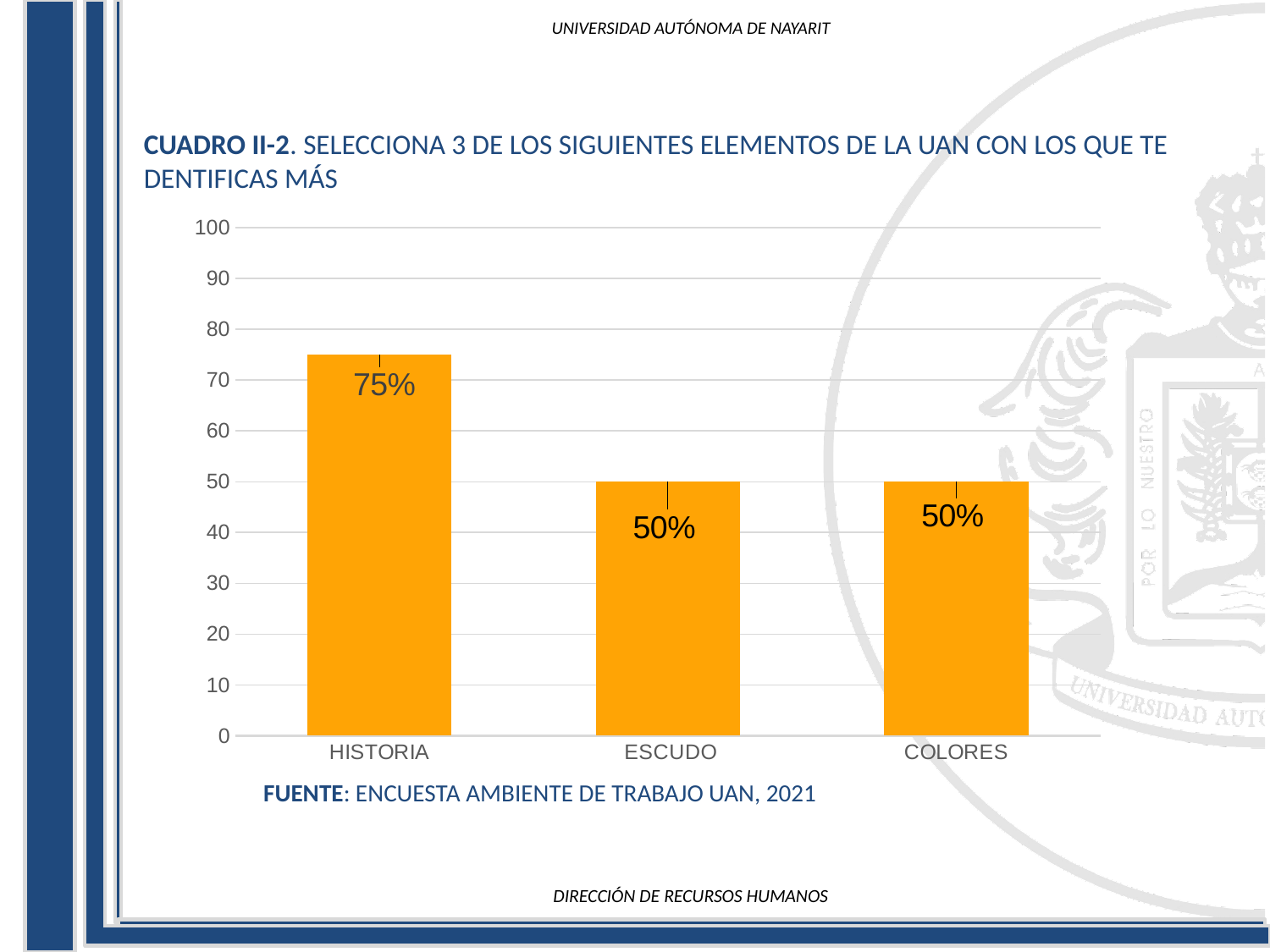
What is the difference between the values for HISTORIA and ESCUDO? 25% Which category has the highest value? HISTORIA What is the value for COLORES? 50% Is the value for HISTORIA greater or less than 70? greater What is the value for ESCUDO? 50% What is the source cited below the chart? ENCUESTA AMBIENTE DE TRABAJO UAN, 2021 What kind of chart is shown on the slide? Bar chart What is the value for HISTORIA? 75% Is the value for ESCUDO greater or less than 60? less What colour are the bars in the chart? Orange Which is larger, the value for HISTORIA or the value for COLORES? HISTORIA How many categories are shown on the x axis? 3